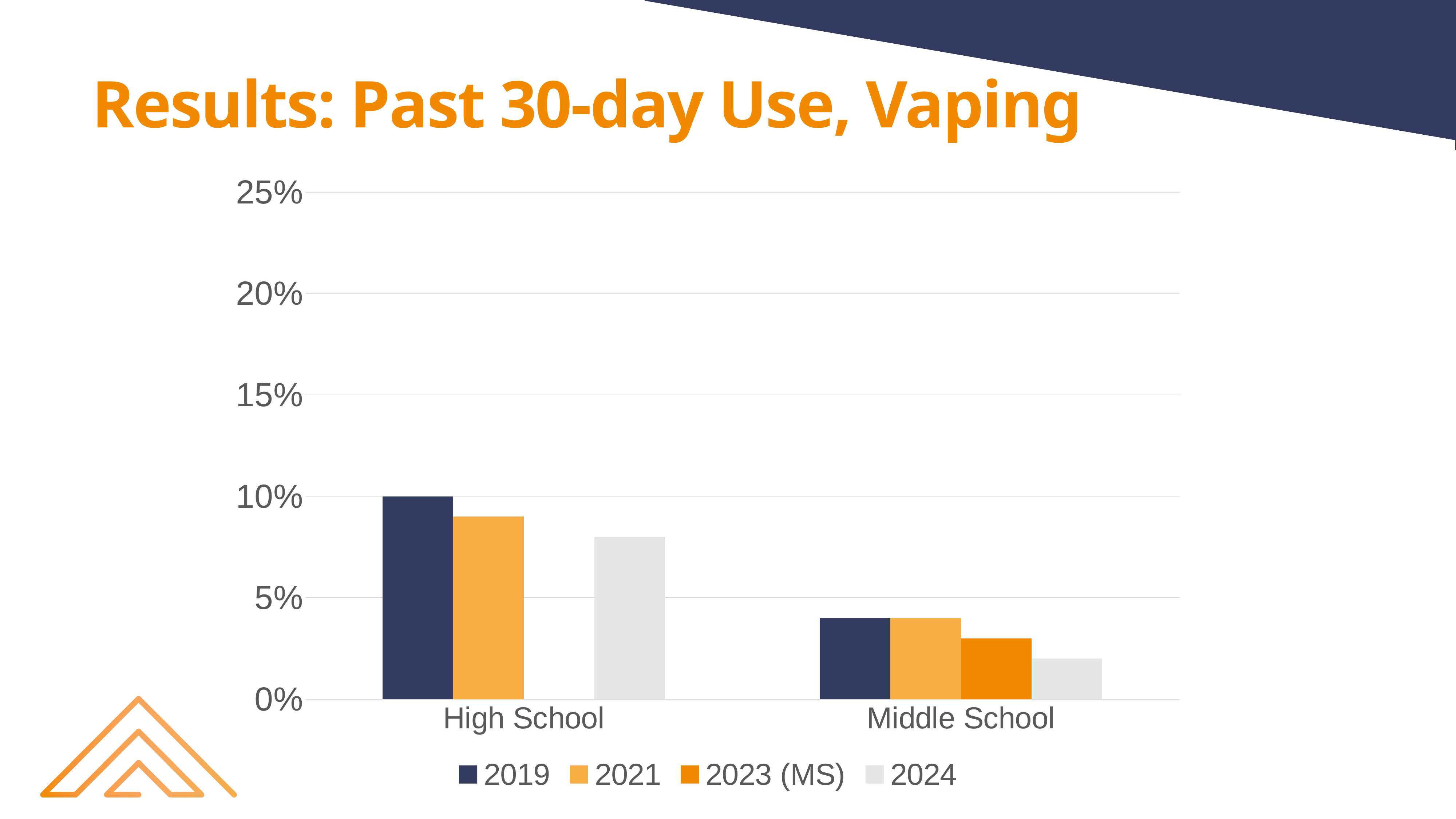
How many categories are shown on the x axis? 2 Which year has the lowest value for Middle School? 2024 Which is larger, the 2019 value for High School or the 2019 value for Middle School? High School How many series does the legend list? 4 What type of chart is shown on the slide? Bar chart Is the value for Middle School in 2024 greater or less than 5%? less Which year has the highest value for High School? 2019 Is the value for High School in 2021 greater or less than 10%? less Which series has no bar for High School? 2023 (MS) What is the value for High School in 2019? 10% Is the value for High School in 2024 greater or less than 5%? greater Which is larger for Middle School, the 2023 (MS) value or the 2024 value? 2023 (MS)